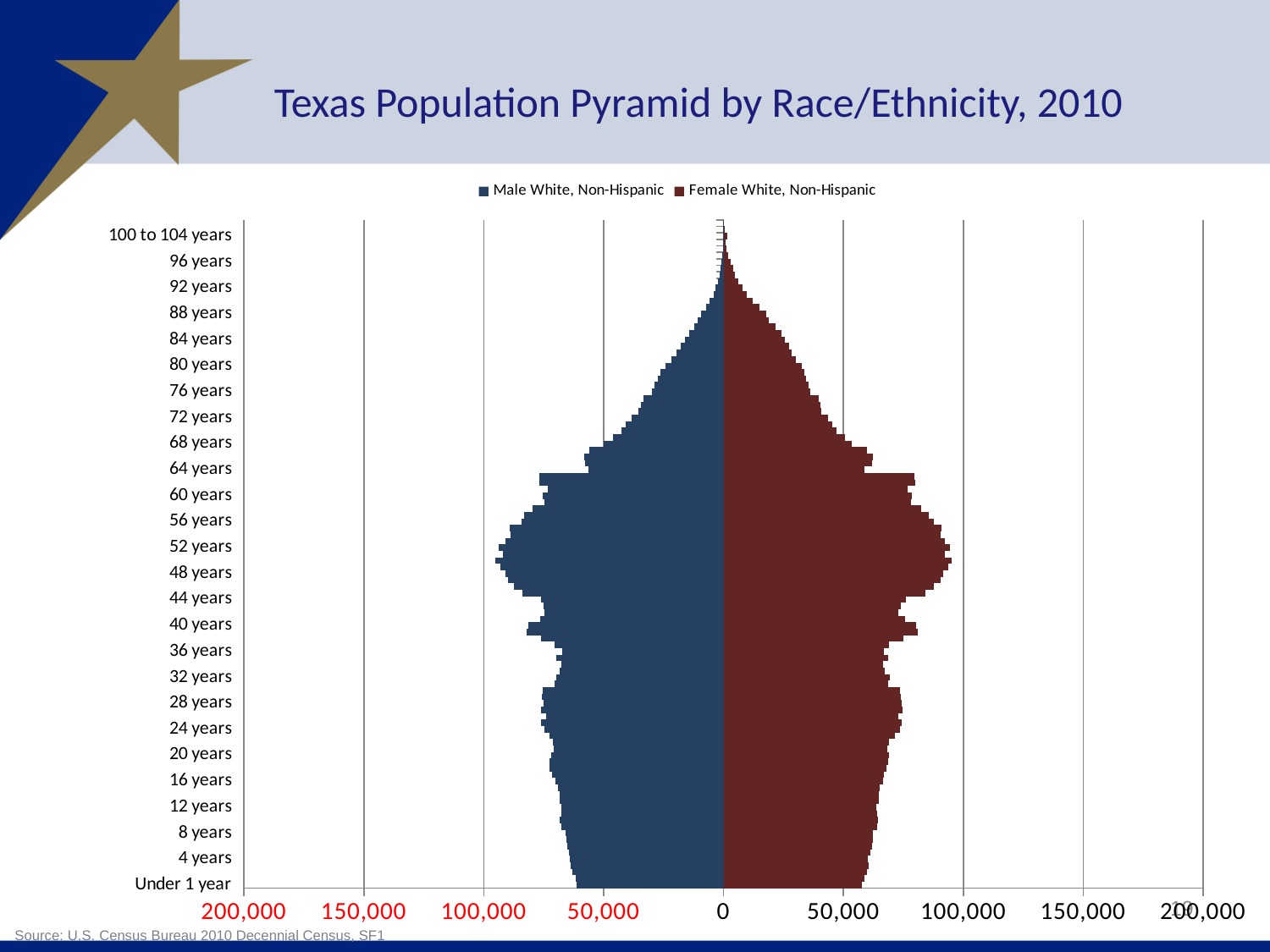
How many series does the legend list? 2 Is the value for Male White, Non-Hispanic at 88 years greater or less than 50,000? less Which series is shown in dark red? Female White, Non-Hispanic What is the title of the chart? Texas Population Pyramid by Race/Ethnicity, 2010 Is the value for Male White, Non-Hispanic at 48 years greater or less than 50,000? greater Is the value for Male White, Non-Hispanic at 60 years greater or less than 50,000? greater What kind of chart is shown on the slide? Bar chart (population pyramid) At 88 years, which is larger: the Male White, Non-Hispanic value or the Female White, Non-Hispanic value? Female White, Non-Hispanic